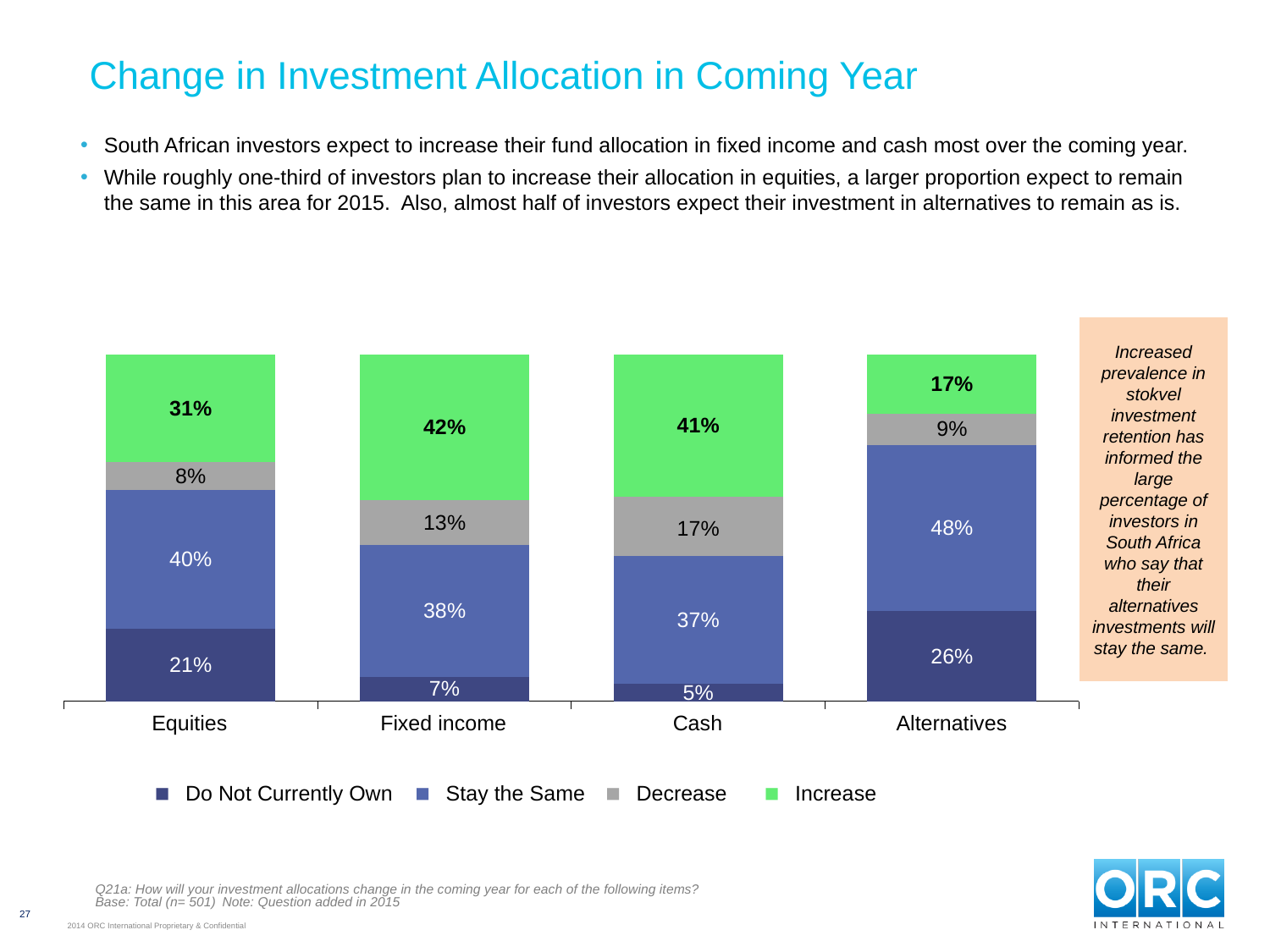
Which category has the highest Increase value? Fixed income How many categories are shown on the x axis? 4 What percentage of investors say their Equities allocation will Stay the Same? 40% What is the difference between the Stay the Same values for Alternatives and Cash? 11% Is the Decrease value larger for Cash or for Equities? Cash How many series does the legend list? 4 What percentage of investors Do Not Currently Own Cash? 5% What is the Decrease value for Alternatives? 9% What is the Increase value for Fixed income? 42% What is the total of the Equities stacked bar? 100% What kind of chart is shown on the slide? Stacked bar chart Which category has the lowest Increase value? Alternatives